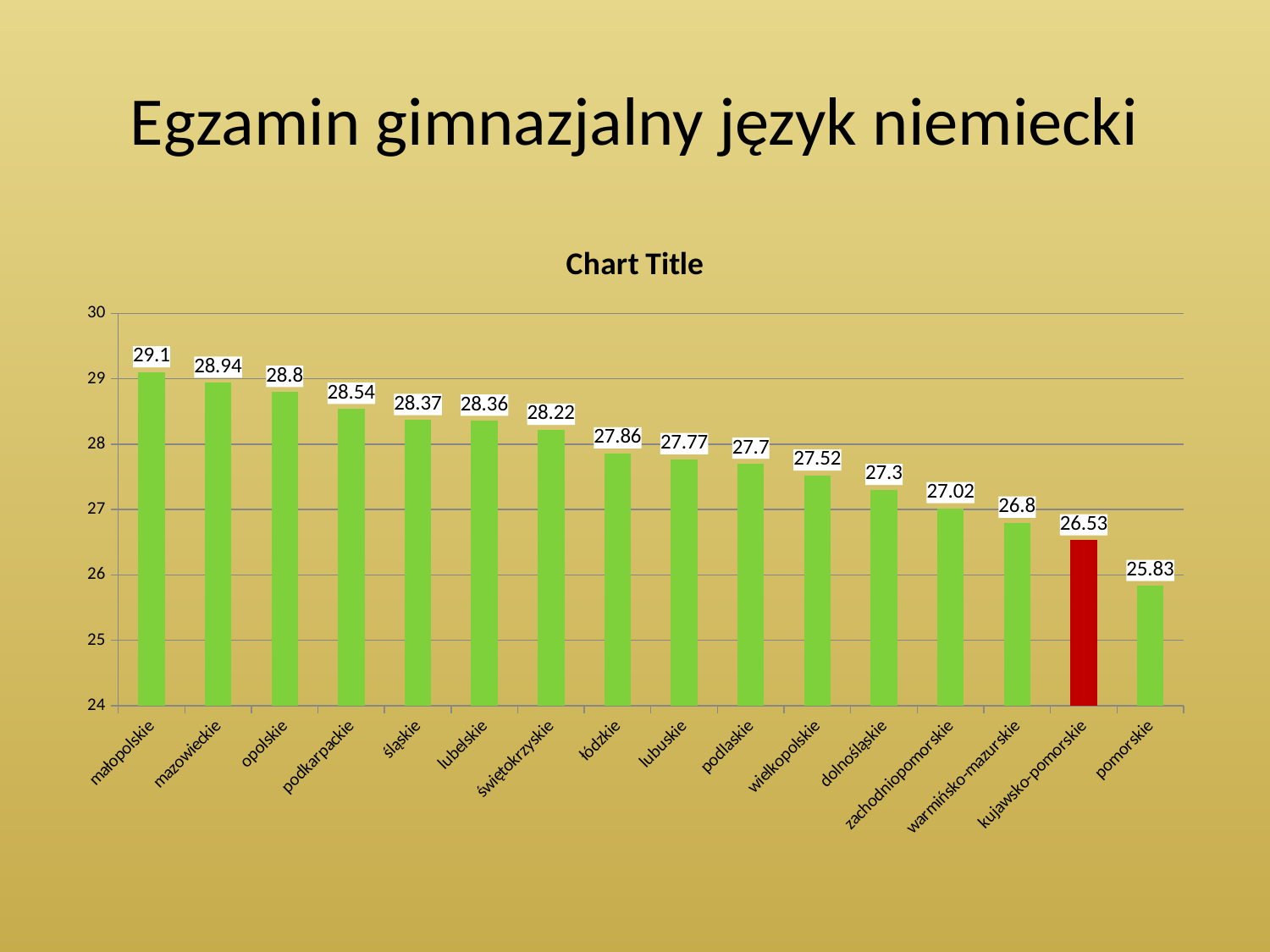
How many categories are shown on the x axis? 16 Is the value for warmińsko-mazurskie greater or less than 27? less Which category has the highest value? małopolskie What is the value for kujawsko-pomorskie? 26.53 What is the value for zachodniopomorskie? 27.02 Which bar is coloured red instead of green? kujawsko-pomorskie What is the difference between the values for mazowieckie and opolskie? 0.14 What kind of chart is shown on the slide? bar chart What is the value for małopolskie? 29.1 What is the difference between the values for małopolskie and pomorskie? 3.27 Which category has the lowest value? pomorskie Which is larger, the value for podkarpackie or the value for łódzkie? podkarpackie